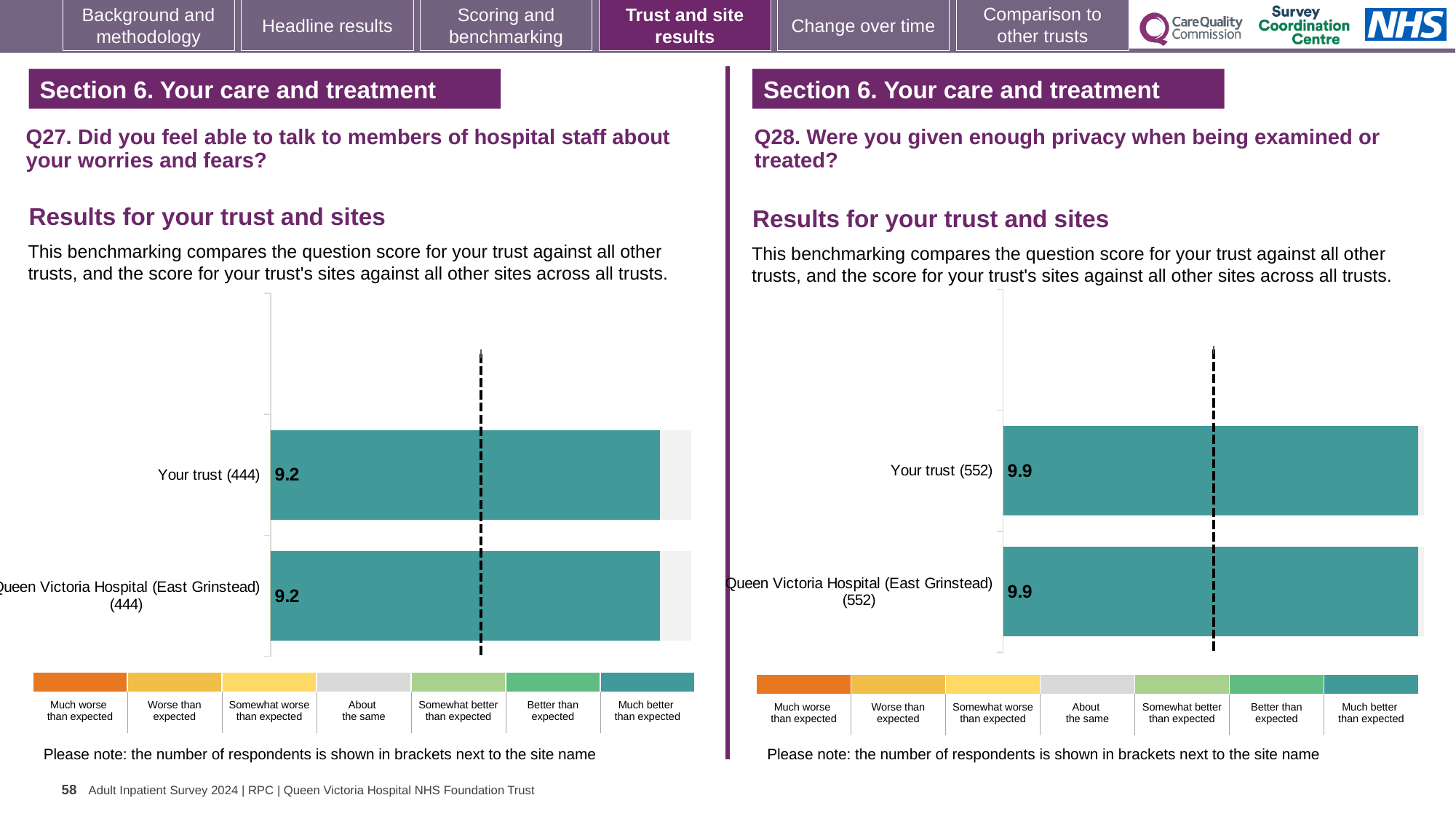
How many bars are plotted on the Q28 chart (right)? 2 What kind of chart is used on the Q28 chart (right)? Bar chart On the Q27 chart (left), what is the score for Queen Victoria Hospital (East Grinstead)? 9.2 On the Q28 chart (right), what is the score for Your trust? 9.9 On the Q27 chart (left), what is the difference between the score for Your trust and the score for Queen Victoria Hospital (East Grinstead)? 0 On the Q28 chart (right), what is the score for Queen Victoria Hospital (East Grinstead)? 9.9 On the Q27 chart (left), how many respondents are shown in brackets next to Your trust? 444 On the Q27 chart (left), what is the score for Your trust? 9.2 On the Q28 chart (right), how many respondents are shown in brackets next to Queen Victoria Hospital (East Grinstead)? 552 On the Q28 chart (right), what is the difference between the score for Your trust and the score for Queen Victoria Hospital (East Grinstead)? 0 Is the score for Your trust on the Q28 chart (right) larger or smaller than the score for Your trust on the Q27 chart (left)? Larger How many bars are plotted on the Q27 chart (left)? 2